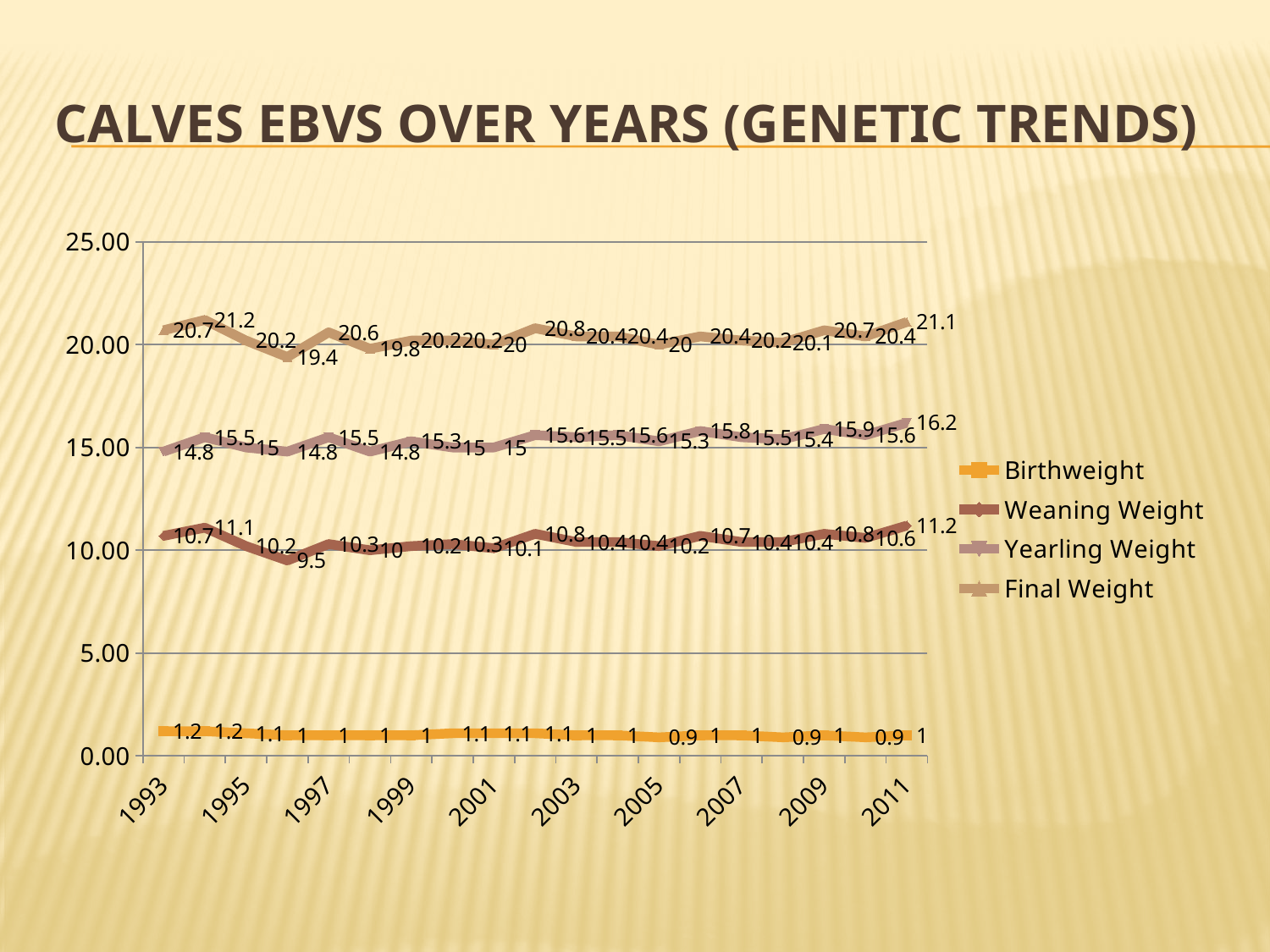
What is the Final Weight value for 2011? 21.1 What is the Birthweight value for 1993? 1.2 What kind of chart is shown on the slide? line chart What is the lowest value plotted for the Weaning Weight series? 9.5 What is the Yearling Weight value for 1993? 14.8 Which year has the larger Yearling Weight value, 1993 or 2011? 2011 What is the highest value plotted for the Final Weight series? 21.2 How much higher is the Final Weight value in 2011 than in 1993? 0.4 What is the Weaning Weight value for 2003? 10.4 Does the Yearling Weight series rise or fall overall from 1993 to 2011? rise How many series does the legend list? 4 Is the Final Weight value for 2011 greater or less than 20.00? greater